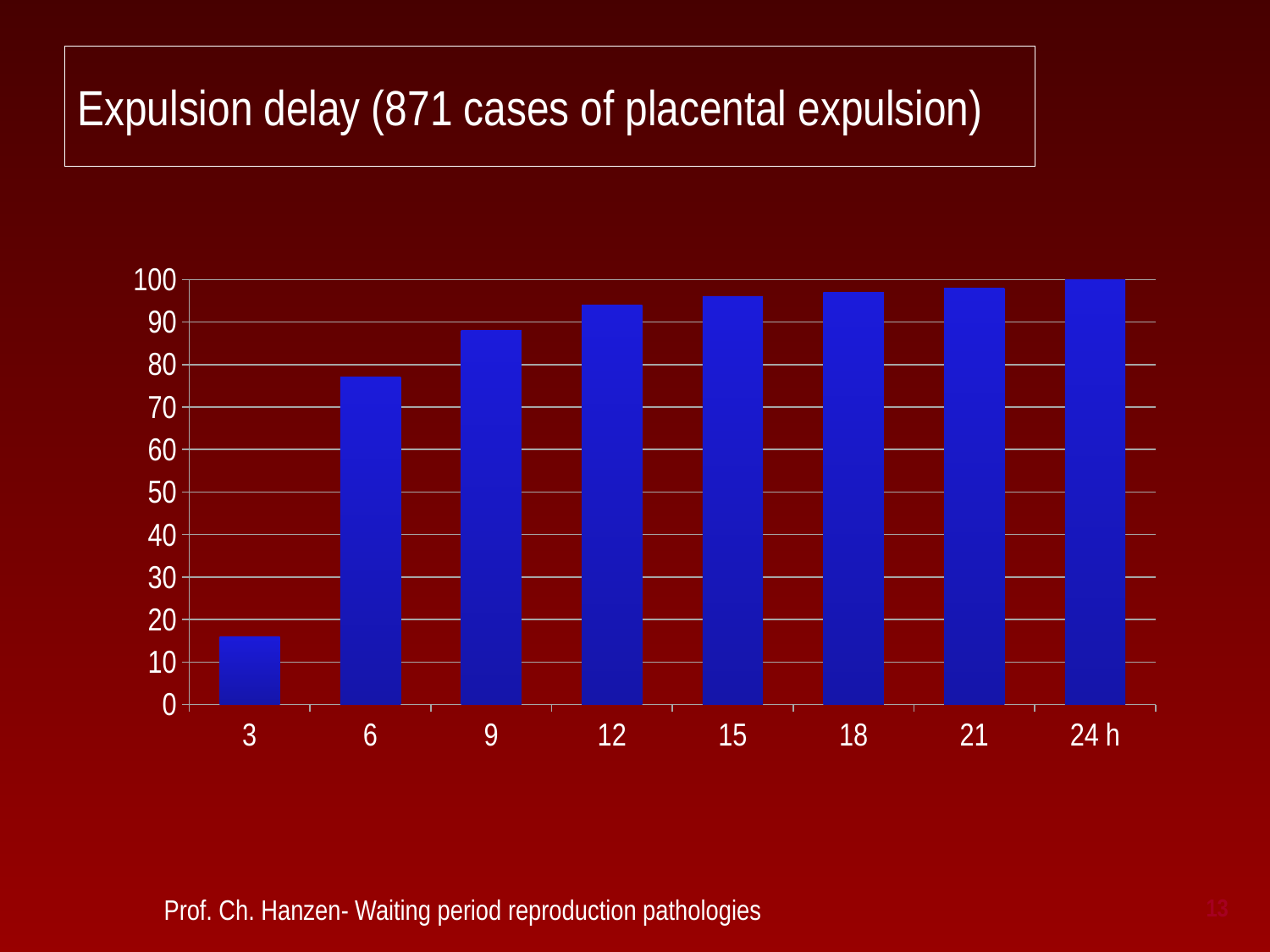
What is the value for the 24 h category? 100 Is the value for category 9 greater or less than 80? greater Is the value for category 3 greater or less than 20? less How many bars (categories) are plotted in the chart? 8 Which category has the lowest bar? 3 Is the value for category 6 greater or less than 70? greater Which is larger, the value for category 6 or the value for category 9? 9 Which category has the highest bar? 24 h Do the values rise or fall as you move from 3 to 24 h along the x axis? rise What kind of chart is shown on the slide? bar chart What is the title of the slide containing the chart? Expulsion delay (871 cases of placental expulsion)